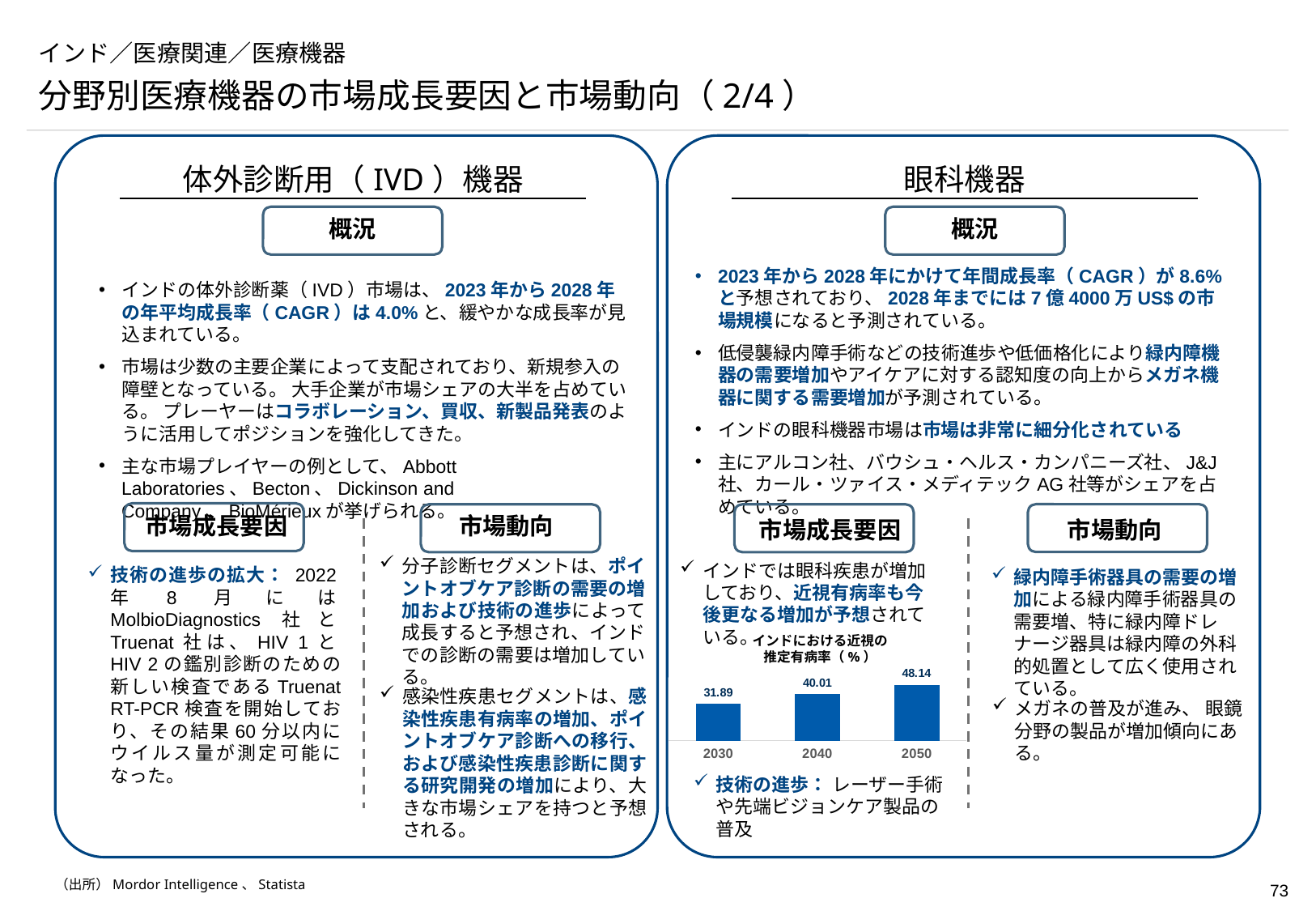
What is the estimated myopia prevalence in India for 2030 in the chart titled インドにおける近視の推定有病率（%）? 31.89 How many years (categories) are plotted in the chart? 3 What value does the chart show for 2050? 48.14 Which year has the lowest estimated myopia prevalence in the chart? 2030 Which year has the highest estimated myopia prevalence in the chart? 2050 What is the difference between the values for 2050 and 2030 in the chart? 16.25 What is the difference between the values for 2040 and 2030 in the chart? 8.12 What kind of chart is used to show the estimated myopia prevalence in India? Bar chart Do the values in the chart rise or fall from 2030 to 2050? Rise Which is larger in the chart, the value for 2040 or the value for 2050? 2050 What is the title of the chart on the slide? インドにおける近視の推定有病率（%） What value does the chart show for 2040? 40.01